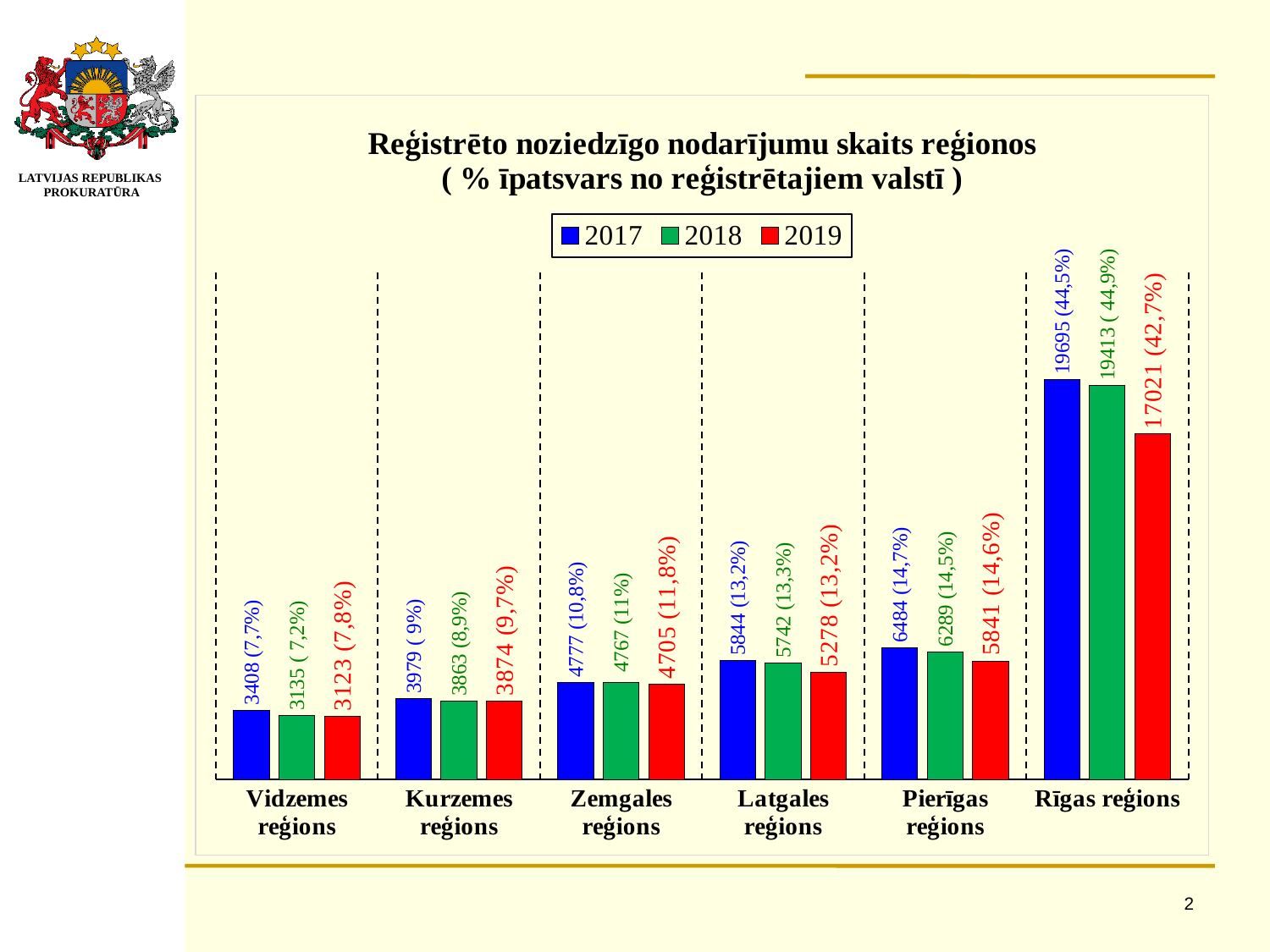
Which region has the lowest value in 2019? Vidzemes reģions How many regions are shown on the x axis? 6 Which region has the highest value in 2017? Rīgas reģions What is the data label for Vidzemes reģions in 2017? 3408 (7,7%) Which is larger, the 2017 value for Pierīgas reģions or the 2017 value for Latgales reģions? Pierīgas reģions What is the data label for Rīgas reģions in 2019? 17021 (42,7%) What type of chart is shown on the slide? bar chart What is the difference between the 2017 and 2019 counts for Rīgas reģions? 2674 Which colour represents the 2018 series in the legend? green Do the values for Pierīgas reģions rise or fall from 2017 to 2019? fall What is the data label for Latgales reģions in 2018? 5742 (13,3%) How many series does the legend list? 3